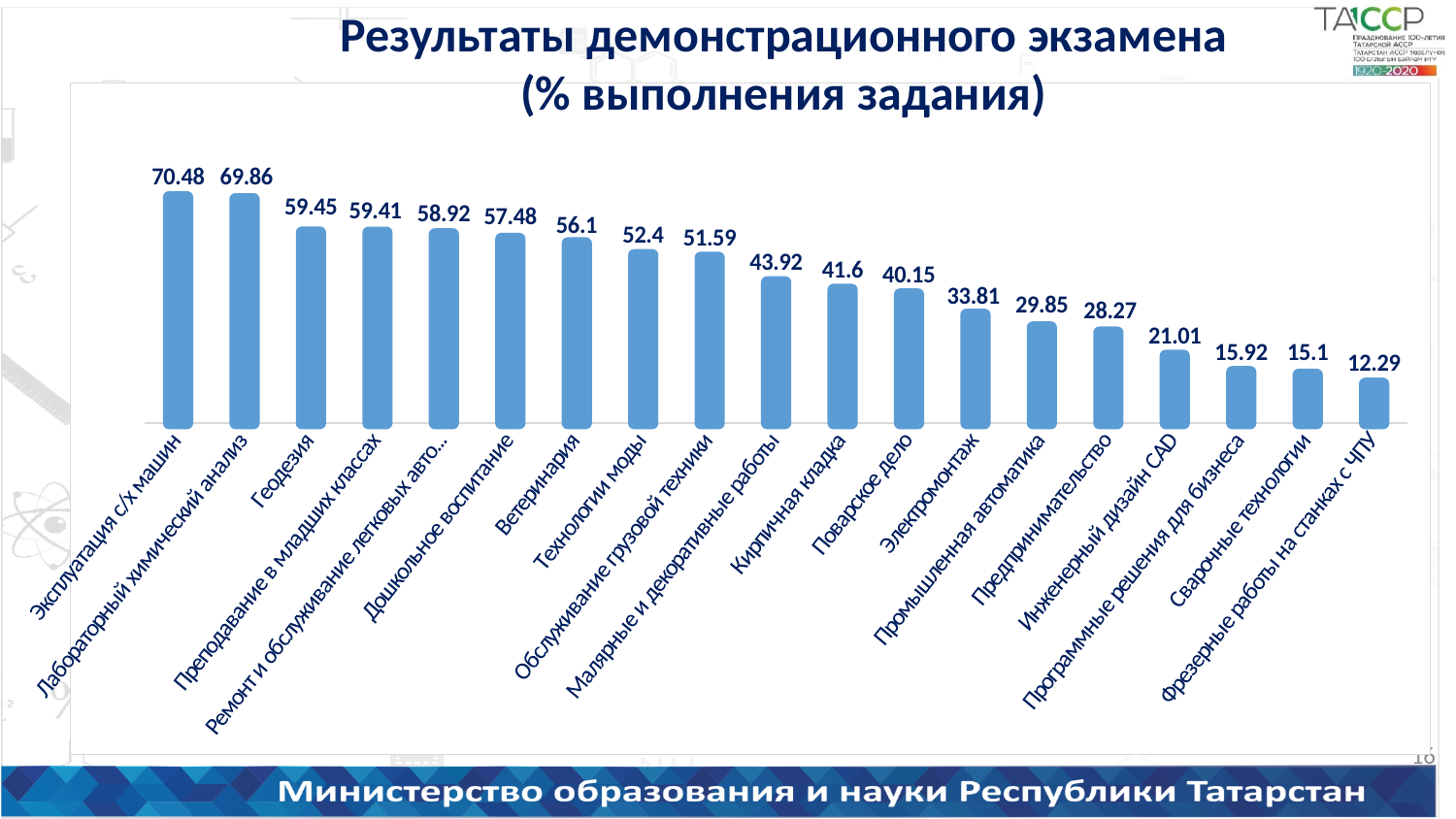
What is the value for Геодезия? 59.45 What kind of chart is shown on the slide? Bar chart What is the value for Поварское дело? 40.15 How many categories are shown in the chart? 19 What is the difference between the values for Кирпичная кладка and Электромонтаж? 7.79 What is the difference between the values for Эксплуатация с/х машин and Фрезерные работы на станках с ЧПУ? 58.19 Do the values rise or fall from left to right along the x axis? Fall Which category has the highest value? Эксплуатация с/х машин What is the value for Инженерный дизайн CAD? 21.01 What is the value for Ветеринария? 56.1 Which is larger, the value for Технологии моды or the value for Малярные и декоративные работы? Технологии моды Which category has the lowest value? Фрезерные работы на станках с ЧПУ